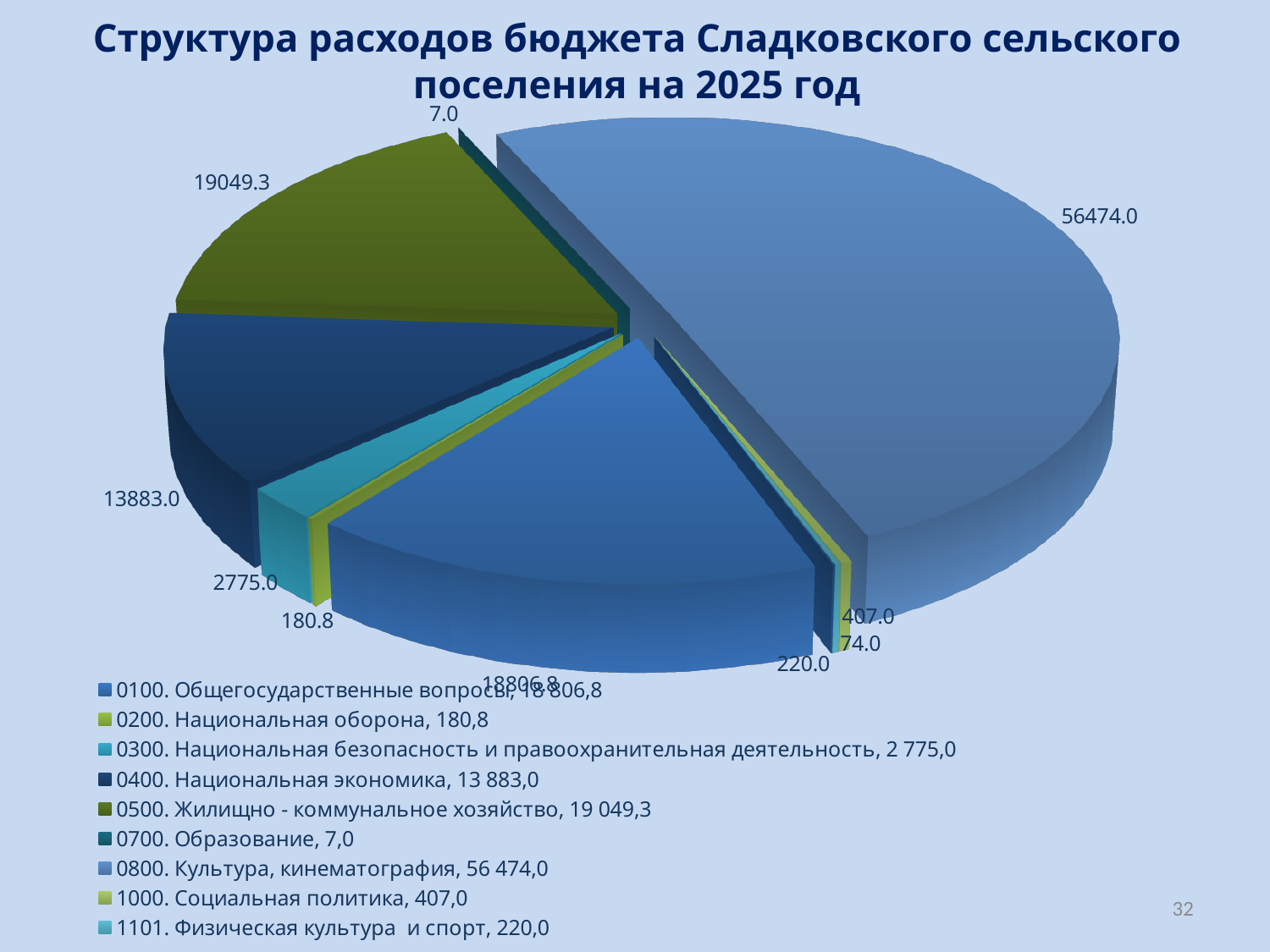
What kind of chart is shown on the slide? pie chart What is the value for 0300. Национальная безопасность и правоохранительная деятельность? 2775.0 What is the difference between the values for 0800. Культура, кинематография and 0500. Жилищно - коммунальное хозяйство? 37424.7 What is the value for 1000. Социальная политика? 407.0 What is the value for 0800. Культура, кинематография? 56474.0 What is the value for 0400. Национальная экономика? 13883.0 What is the difference between the values for 0500. Жилищно - коммунальное хозяйство and 0100. Общегосударственные вопросы? 242.5 Which category has the largest slice of the pie? 0800. Культура, кинематография Which is larger, the value for 0400. Национальная экономика or the value for 0300. Национальная безопасность и правоохранительная деятельность? 0400. Национальная экономика What is the value for 0700. Образование? 7.0 Which category has the smallest slice of the pie? 0700. Образование What is the title of the chart? Структура расходов бюджета Сладковского сельского поселения на 2025 год